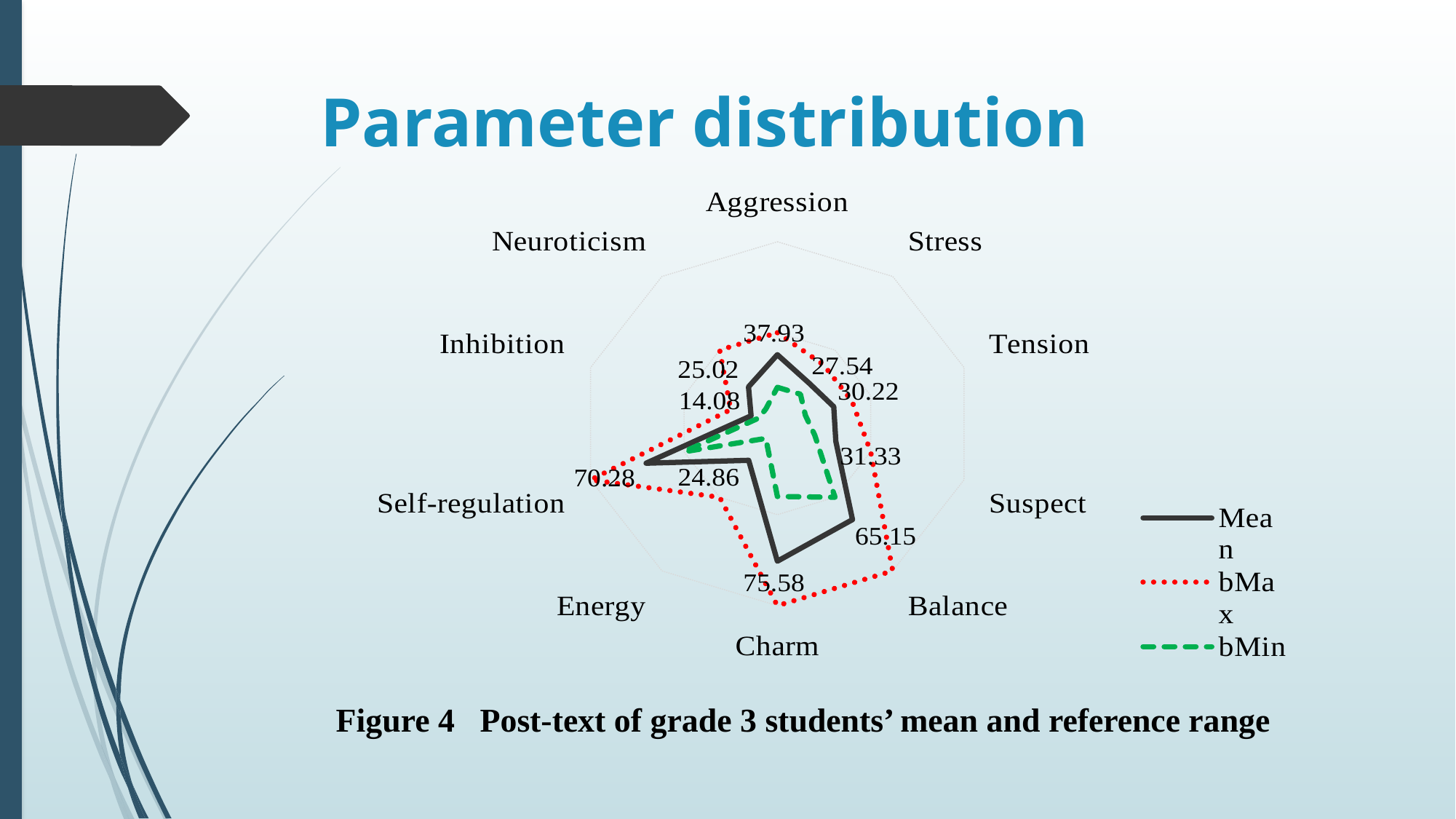
What is the difference between the Mean values for Charm and Balance? 10.43 What kind of chart is shown on the slide? Radar chart What is the Mean value for Aggression? 37.93 How many categories are plotted on the radar chart? 10 How many series does the legend list? 3 What is the Mean value for Inhibition? 14.08 What is the Mean value for Charm? 75.58 Which has a larger Mean value, Balance or Suspect? Balance Which category has the lowest Mean value? Inhibition Which category has the highest Mean value? Charm Which series is drawn as a red dotted line? bMax What is the Mean value for Self-regulation? 70.28